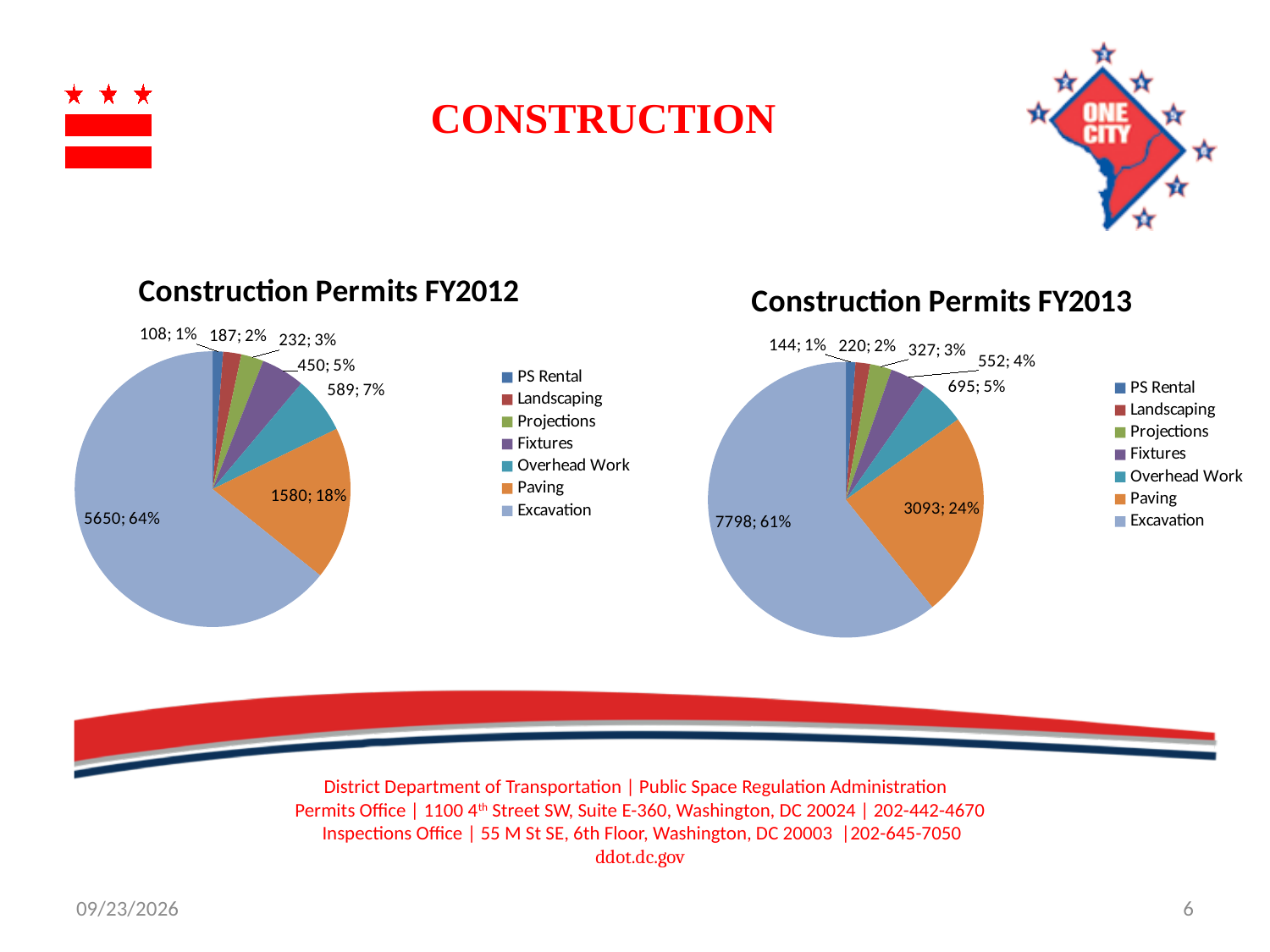
In the Construction Permits FY2012 chart, which is larger, Overhead Work or Fixtures? Overhead Work In the Construction Permits FY2013 chart, which category has the smallest slice? PS Rental In the Construction Permits FY2013 chart, what value is shown for Fixtures? 552 What type of chart is the Construction Permits FY2012 chart? Pie chart In the Construction Permits FY2012 chart, which category has the largest slice? Excavation How many categories does the legend of the Construction Permits FY2013 chart list? 7 In the Construction Permits FY2012 chart, what value is shown for Excavation? 5650 In the Construction Permits FY2012 chart, what share of the pie does Paving represent? 18% What is the title of the chart on the left side of the slide? Construction Permits FY2012 In the Construction Permits FY2013 chart, what share of the pie does Excavation represent? 61% In the Construction Permits FY2013 chart, what value is shown for Paving? 3093 What is the difference between the Paving value in the FY2013 chart and the Paving value in the FY2012 chart? 1513